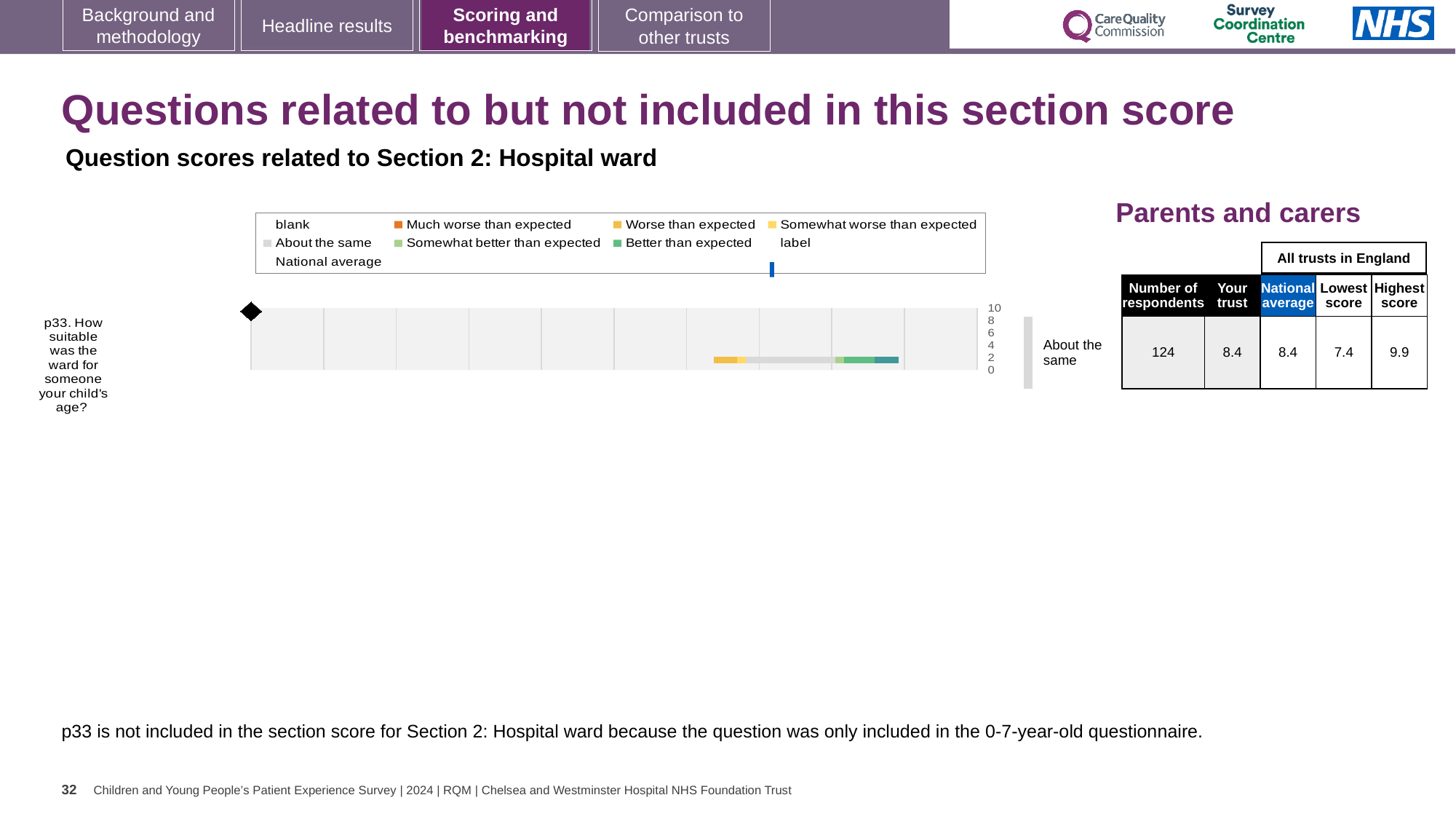
What kind of chart is used to show the p33 result? bar chart In the table beside the chart, what is the highest score among all trusts in England for p33? 9.9 How many questions are plotted in the chart? 1 How many entries does the chart legend list? 9 What is the highest tick value shown on the chart's score axis? 10 In the table beside the chart, what is the national average score for p33? 8.4 In the table beside the chart, what is the 'Your trust' score for p33? 8.4 What is the difference between the trust's score and the national average for p33? 0 Which benchmark category label is shown next to the bar for p33? About the same In the table beside the chart, how many respondents answered p33? 124 What is the subtitle above the chart? Question scores related to Section 2: Hospital ward What is the difference between the highest score (9.9) and the lowest score (7.4) for p33? 2.5